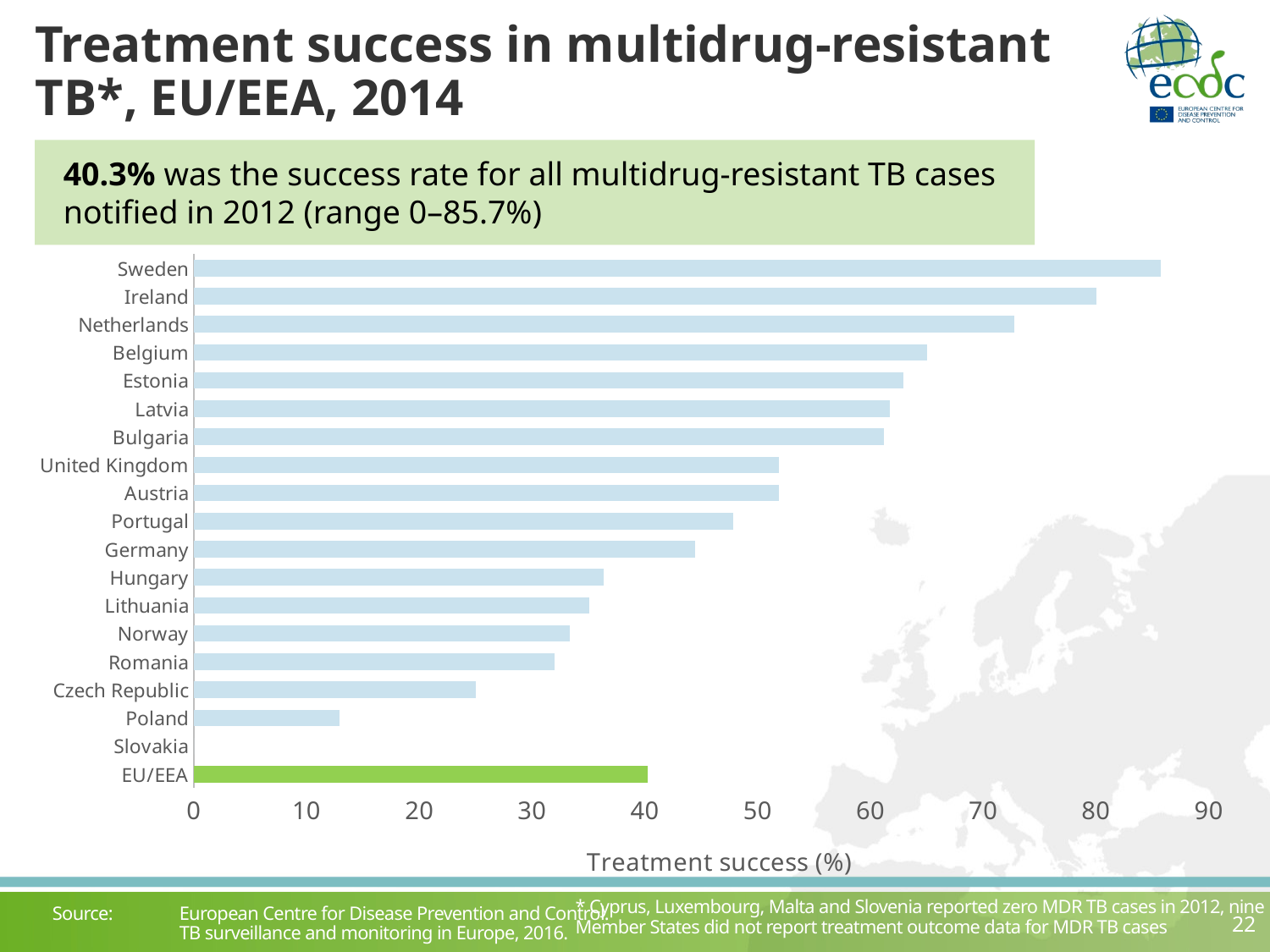
Which has a higher treatment success rate, Poland or Czech Republic? Czech Republic How many categories (bars) are listed on the y axis of the chart? 19 What kind of chart is shown on the slide? bar chart Which category has the lowest treatment success rate in the chart? Slovakia Is the value for Poland greater or less than 20? less Is the value for Sweden greater or less than 80? greater Which has a higher treatment success rate, Ireland or Netherlands? Ireland Is the value for Germany greater or less than 50? less What is the treatment success rate for EU/EEA as stated on the slide? 40.3% Which country has the highest treatment success rate in the chart? Sweden What is the title of the x axis of the chart? Treatment success (%)